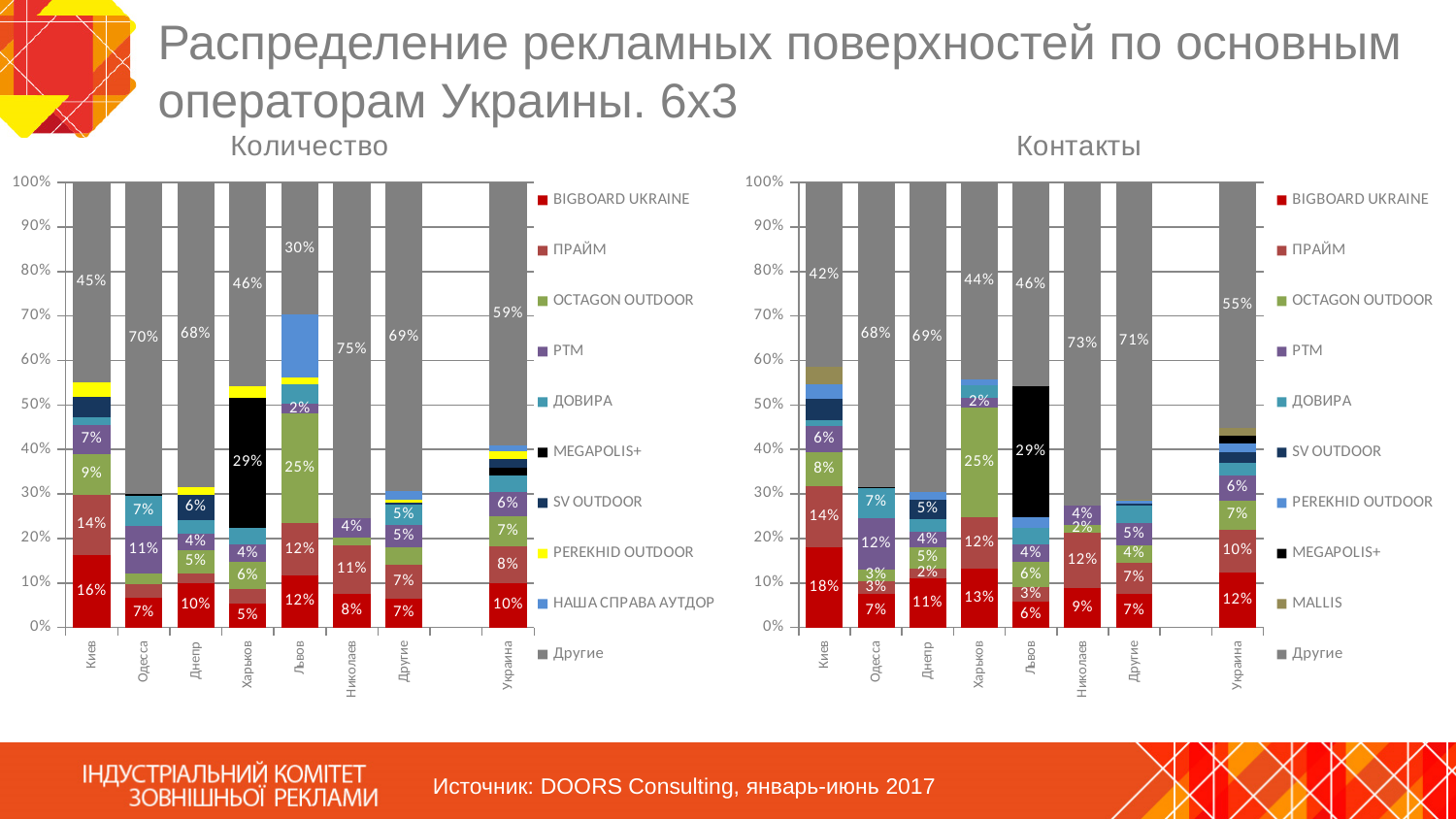
On the 'Количество' chart, which category has the smallest 'Другие' segment? Львов How many series does the legend of the 'Количество' chart list? 10 On the 'Количество' chart, what is the BIGBOARD UKRAINE share for Киев? 16% On the 'Количество' chart, which category has the largest 'Другие' segment? Николаев Which series appears in the legend of the 'Контакты' chart but not in the legend of the 'Количество' chart? MALLIS On the 'Контакты' chart, what is the difference between the BIGBOARD UKRAINE shares for Киев and Украина? 6% What type of chart is the 'Контакты' chart? Stacked bar chart How many categories are shown on the x axis of the 'Контакты' chart? 8 On the 'Контакты' chart, what is the 'Другие' segment value for Николаев? 73% On the 'Количество' chart, what is the value of the 'Другие' segment for Львов? 30% On the 'Количество' chart, which is larger: the OCTAGON OUTDOOR share for Львов or for Киев? Львов On the 'Контакты' chart, what is the MEGAPOLIS+ share for Львов? 29%